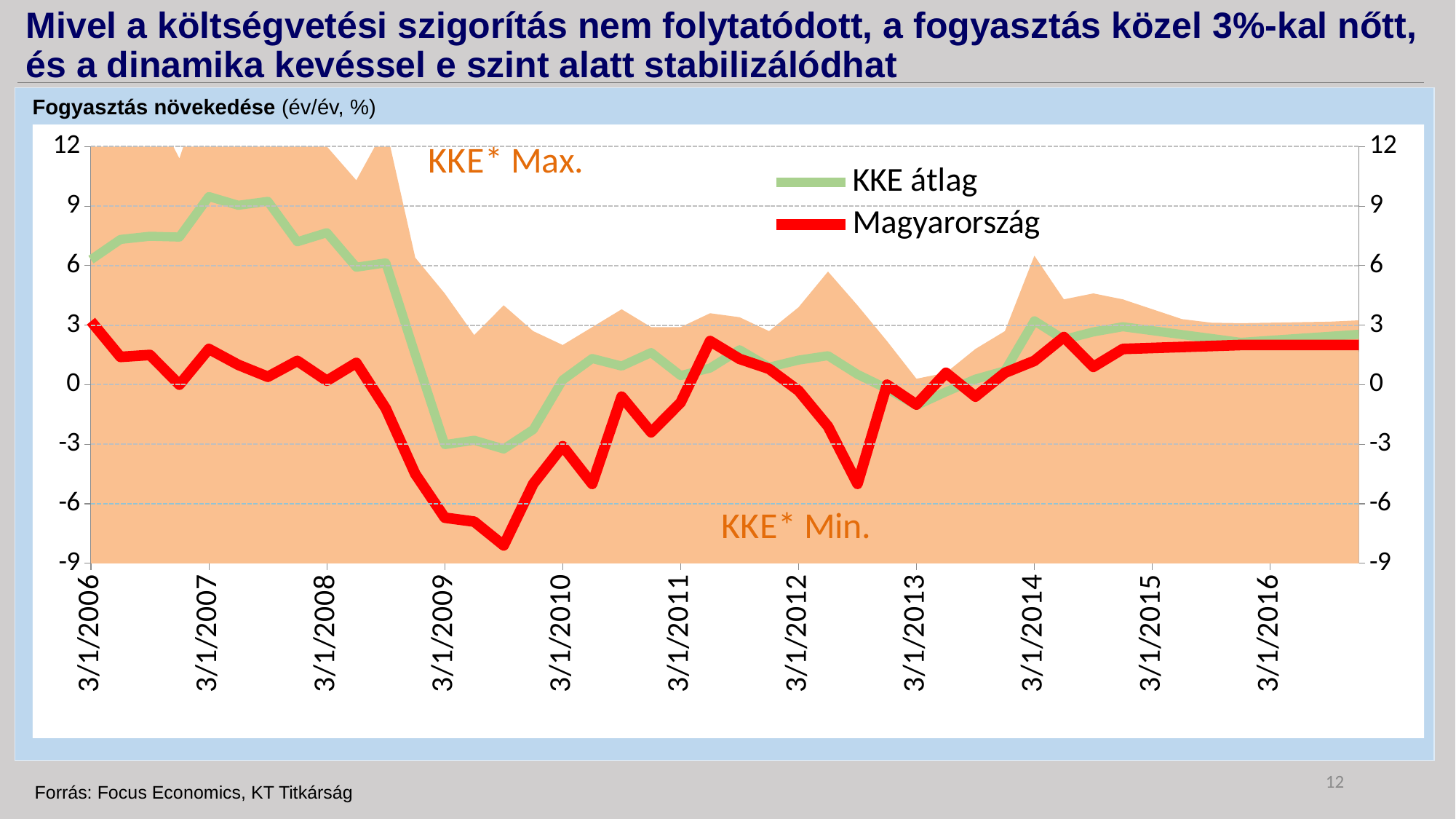
Is the value for KKE átlag at 3/1/2008 greater or less than 6? greater Is the value for Magyarország at 3/1/2016 greater or less than 3? less What colour is the Magyarország line? red What is the title of the chart? Fogyasztás növekedése (év/év, %) Does the Magyarország line rise or fall between 3/1/2008 and 3/1/2009? fall Is the value for KKE átlag at 3/1/2007 greater or less than 6? greater At 3/1/2007, which series has the larger value, KKE átlag or Magyarország? KKE átlag In which year does the Magyarország line reach its lowest value? 2009 What kind of chart is shown on the slide? combination area and line chart How many series does the legend list? 2